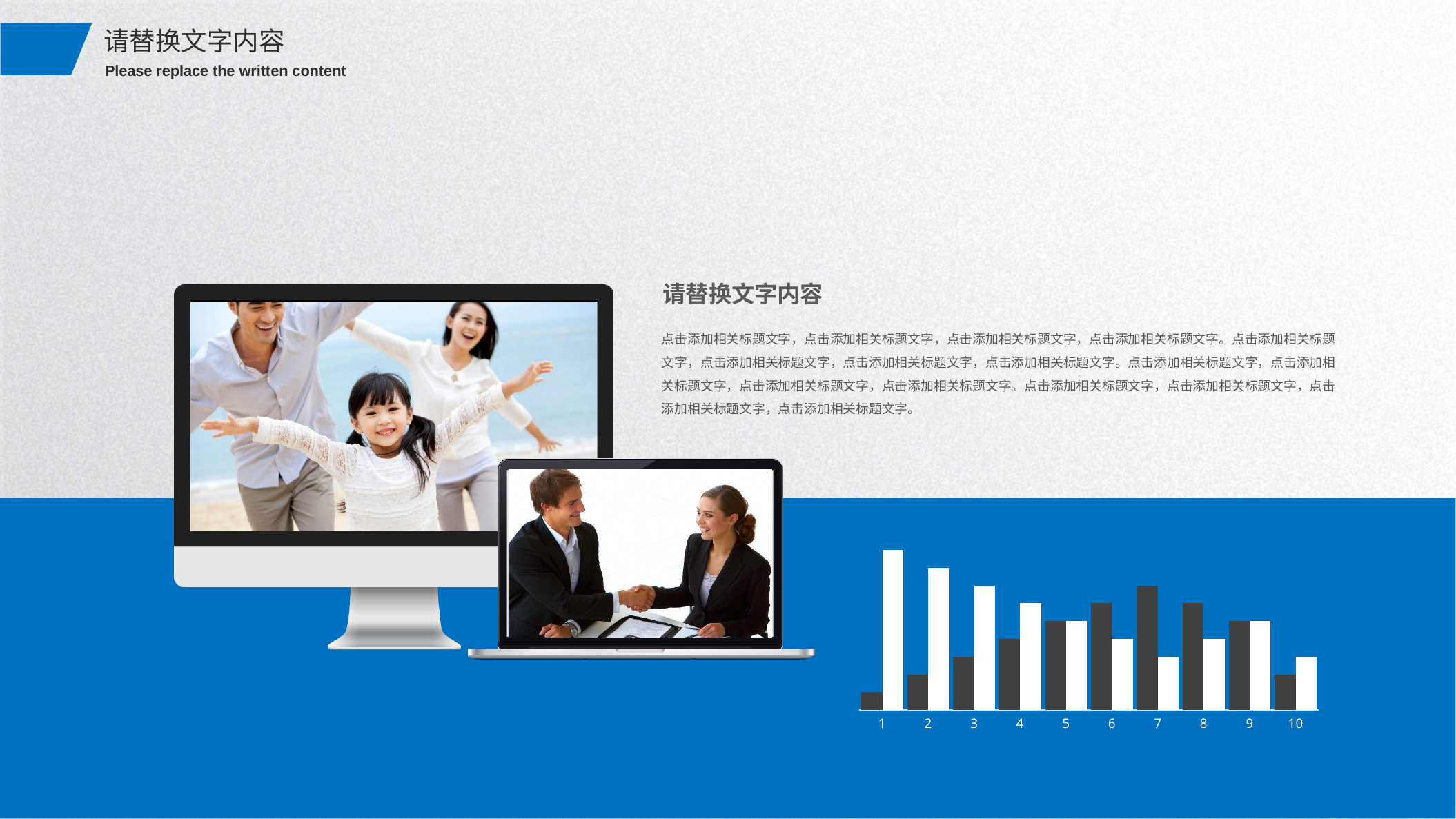
Do the white bars rise or fall from category 1 to category 4? fall What colours are the two bar series in the chart? dark gray and white In category 1, which bar is taller, the white bar or the dark bar? the white bar Which category has the shortest dark bar in the bar chart? 1 How many series (bar colours) are plotted in the bar chart? 2 What kind of chart is shown at the bottom right of the slide? bar chart Which is taller, the white bar for category 2 or the white bar for category 9? category 2 Which category has the tallest white bar in the bar chart? 1 In category 3, which bar is taller, the white bar or the dark bar? the white bar Which category has the tallest dark bar in the bar chart? 7 How many categories are shown on the x axis of the bar chart? 10